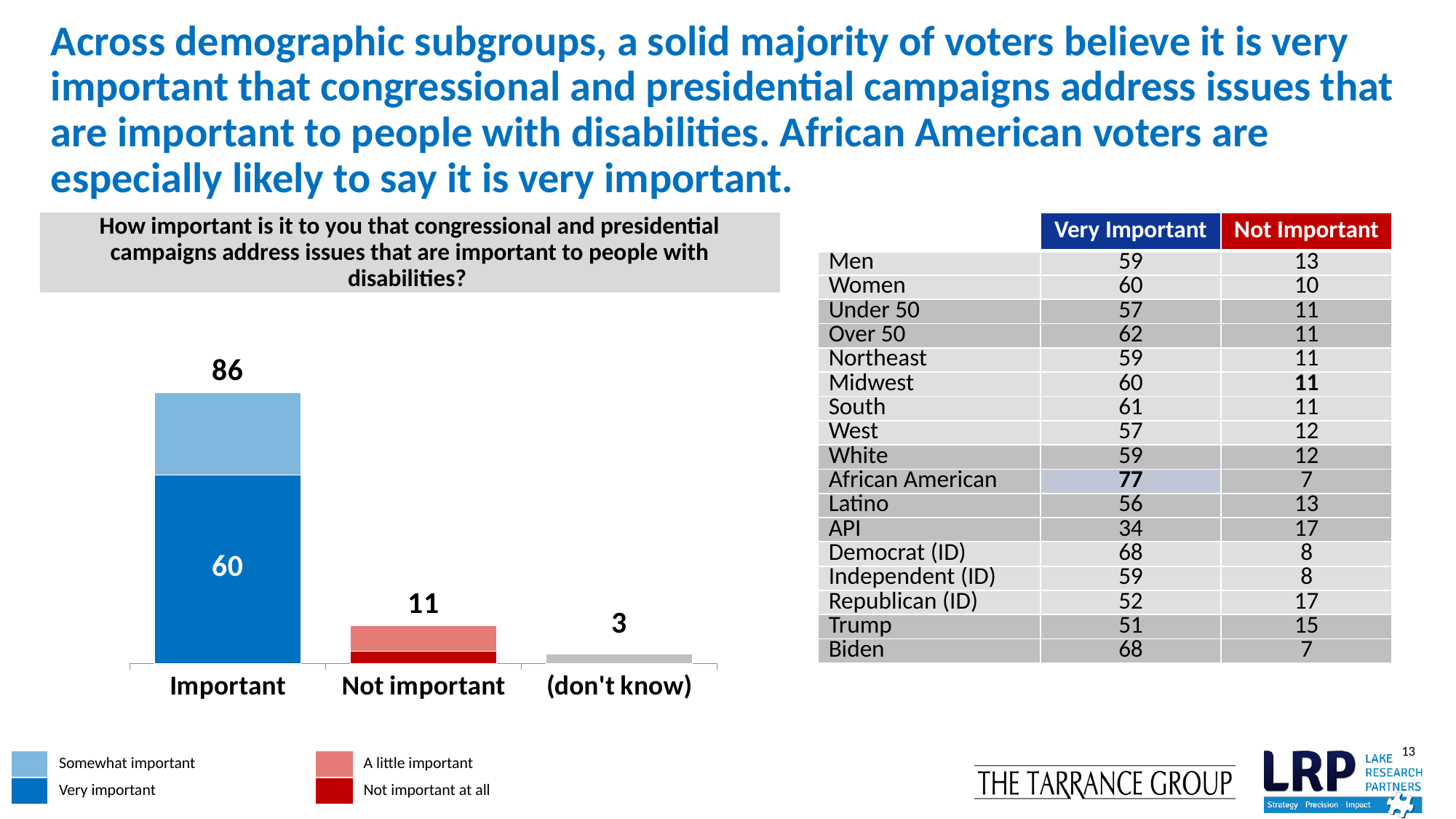
How many categories are shown on the x axis of the chart? 3 What is the value shown for the "(don't know)" bar? 3 Which category has the highest total value in the chart? Important What is the total value shown for the "Not important" bar? 11 What is the difference between the total for "Important" and the total for "Not important"? 75 What is the value labelled on the "Very important" segment of the "Important" bar? 60 What kind of chart is shown on the slide? Stacked bar chart Which legend entry is shown in dark blue? Very important What is the total value shown for the "Important" bar? 86 Which category has the lowest value in the chart? (don't know) Based on the printed labels, what is the value of the "Somewhat important" segment of the "Important" bar? 26 Which is larger: the total for "Not important" or the value for "(don't know)"? Not important